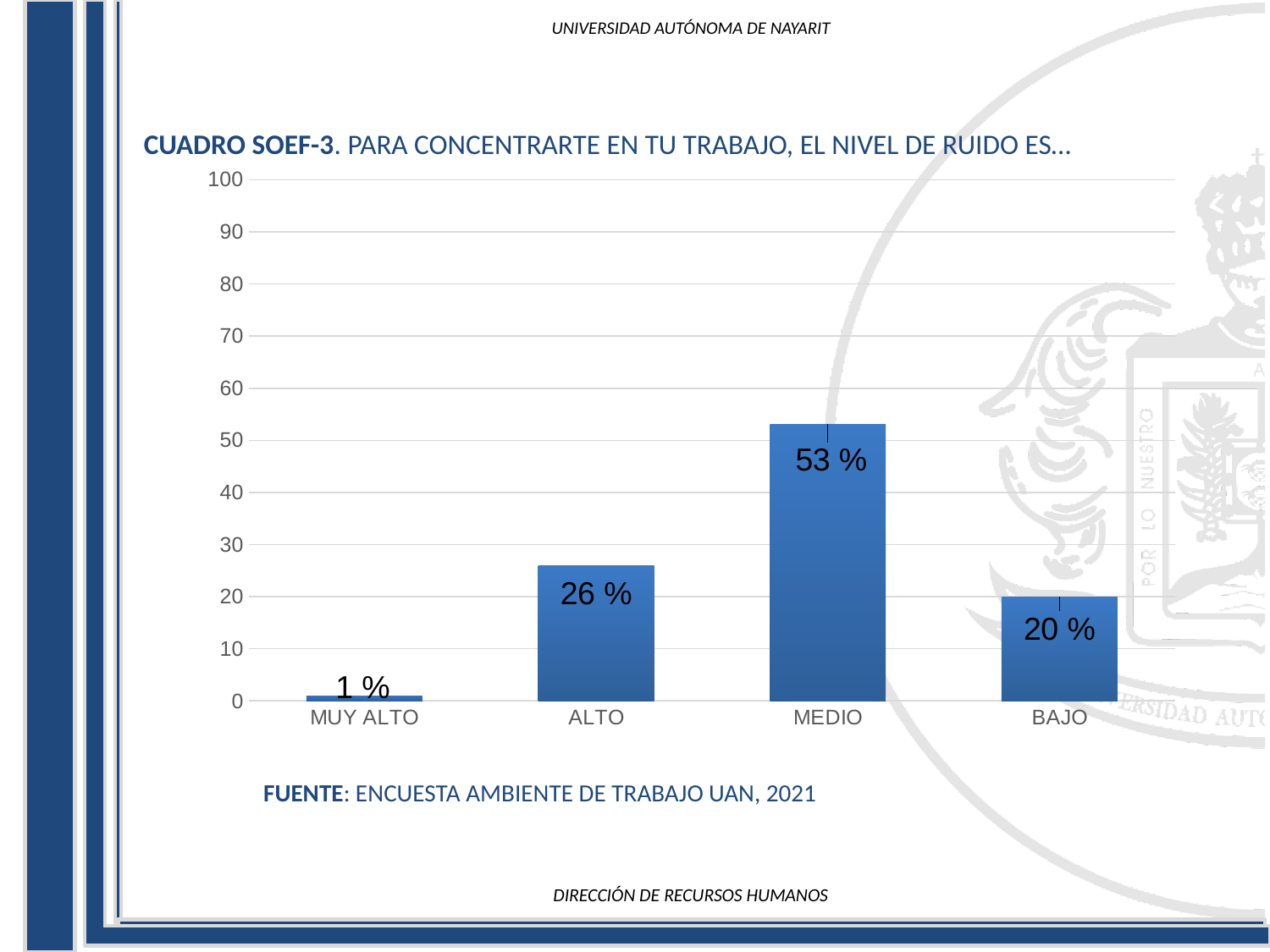
How many categories are shown on the x axis? 4 What kind of chart is shown on the slide? bar chart What is the value for MUY ALTO? 1 % Which is larger, the value for ALTO or the value for BAJO? ALTO What is the value for BAJO? 20 % What is the difference between the values for MEDIO and ALTO? 27 % Which category has the highest value? MEDIO Which category has the lowest value? MUY ALTO What is the value for MEDIO? 53 % Is the value for MEDIO greater or less than 50? greater What is the value for ALTO? 26 % What is the source cited below the chart? ENCUESTA AMBIENTE DE TRABAJO UAN, 2021